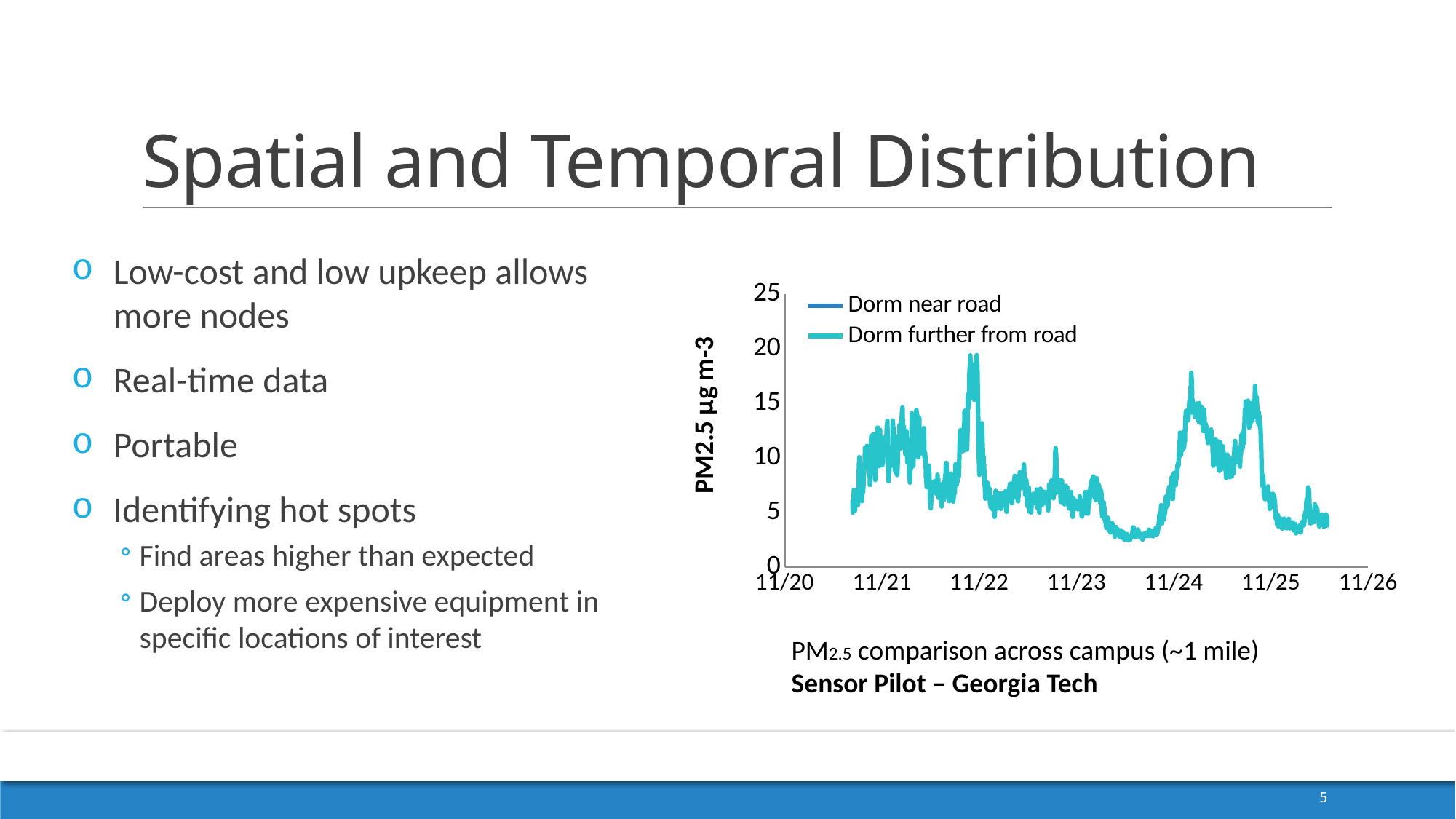
How many series does the chart legend list? 2 What is the highest value shown on the chart's y axis? 25 Is the highest peak of the Dorm further from road line, near 11/22, greater or less than 15? greater Does the Dorm further from road line rise or fall from 11/25 to the end of the plotted data? fall What are the two series named in the chart legend? Dorm near road; Dorm further from road What kind of chart is shown on the slide? Line chart Is the Dorm further from road value midway between 11/23 and 11/24 greater or less than 5? less Is the Dorm further from road value at 11/21 greater or less than 20? less How many date ticks are labelled on the chart's x axis? 7 What is the label on the chart's y axis? PM2.5 µg m-3 What is the first date shown on the chart's x axis? 11/20 What is the last date shown on the chart's x axis? 11/26